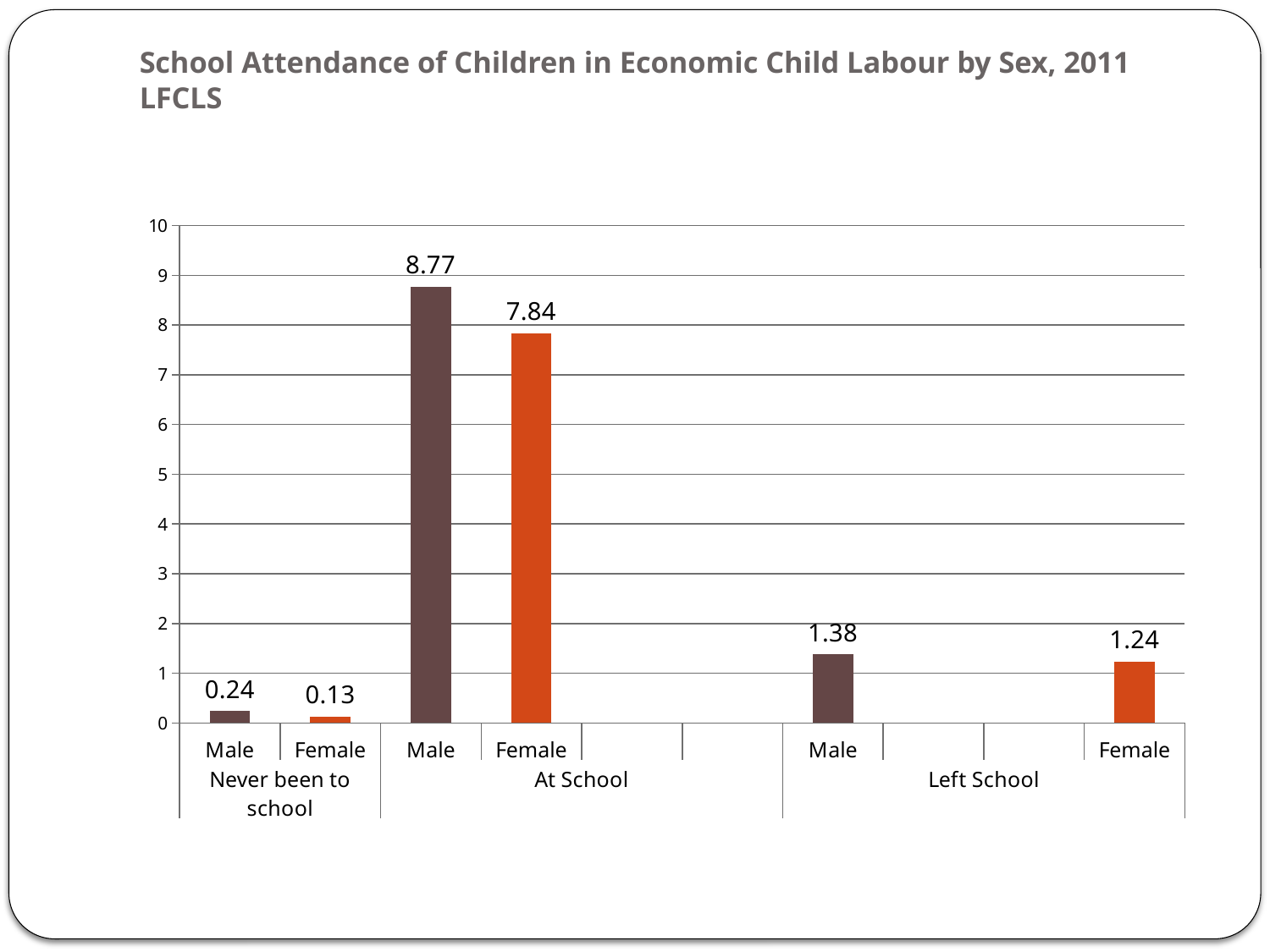
What is the value for Female in the Left School group? 1.24 What kind of chart is shown on the slide? Bar chart How many bars are plotted on the chart? 6 Which bar has the lowest value on the chart? Female, Never been to school What is the value for Male in the At School group? 8.77 Which is larger: the Male value for Never been to school or the Female value for Never been to school? Male What is the difference between the Male and Female values in the Left School group? 0.14 Which bar has the highest value on the chart? Male, At School What is the value for Male in the Left School group? 1.38 What is the difference between the Male and Female values in the At School group? 0.93 What is the value for Female in the Never been to school group? 0.13 Is the value for Female in the At School group greater or less than 8? less